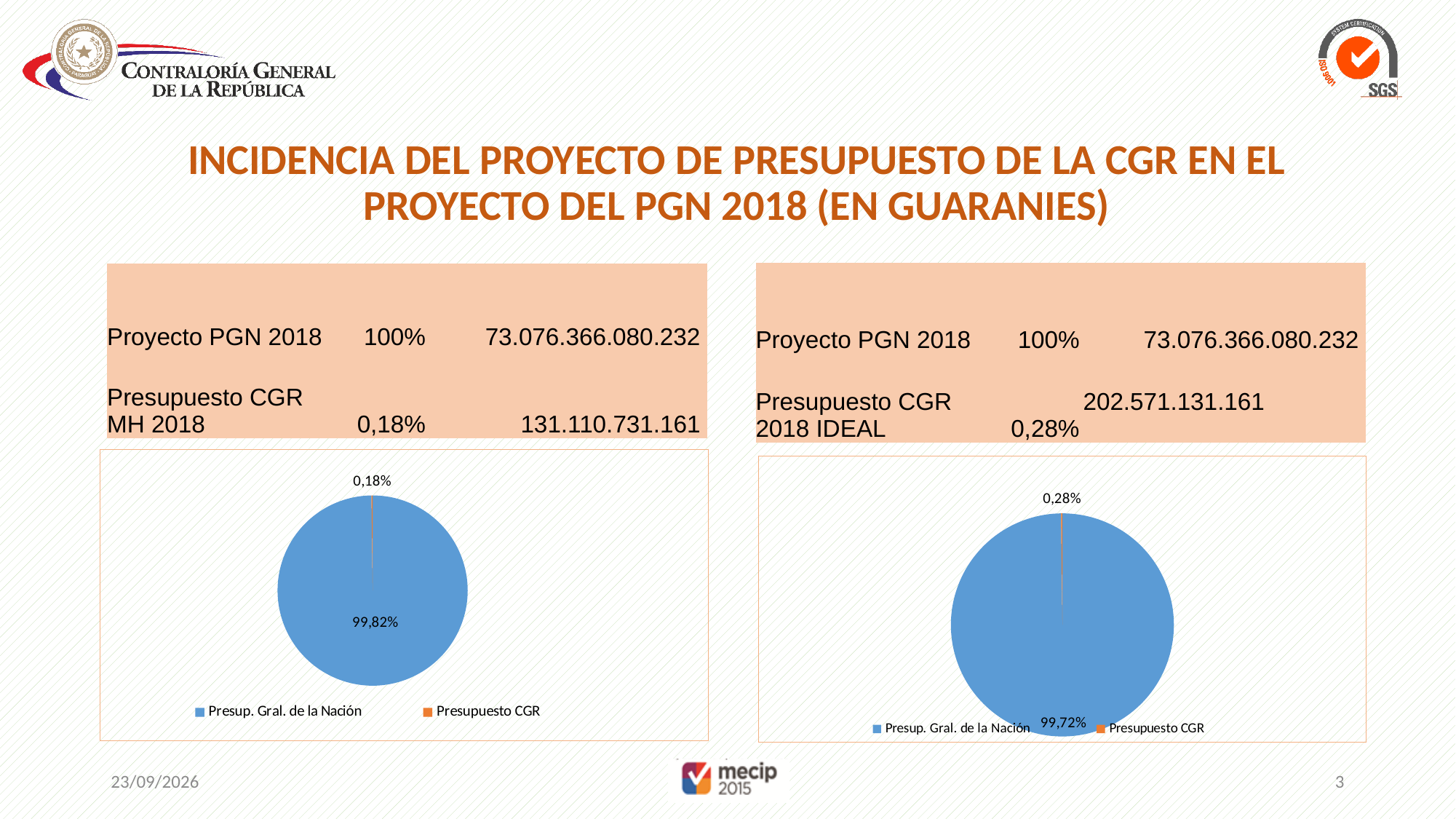
What type of chart is shown on the left side of the slide? Pie chart How many slices does the left pie chart have? 2 In the left pie chart, what colour is the Presup. Gral. de la Nación slice? Blue In the left pie chart, which slice is the largest? Presup. Gral. de la Nación How many entries does the legend of the right pie chart list? 2 In the left pie chart, what share is labelled for Presup. Gral. de la Nación? 99,82% In the right pie chart, which slice is the smallest? Presupuesto CGR In the right pie chart, what share is labelled for Presupuesto CGR? 0,28% In the left pie chart, what share is labelled for Presupuesto CGR? 0,18% What is the difference between the Presupuesto CGR share in the right pie chart and in the left pie chart? 0,10% Which is larger: the Presupuesto CGR share in the left pie chart or in the right pie chart? Right pie chart In the right pie chart, what share is labelled for Presup. Gral. de la Nación? 99,72%